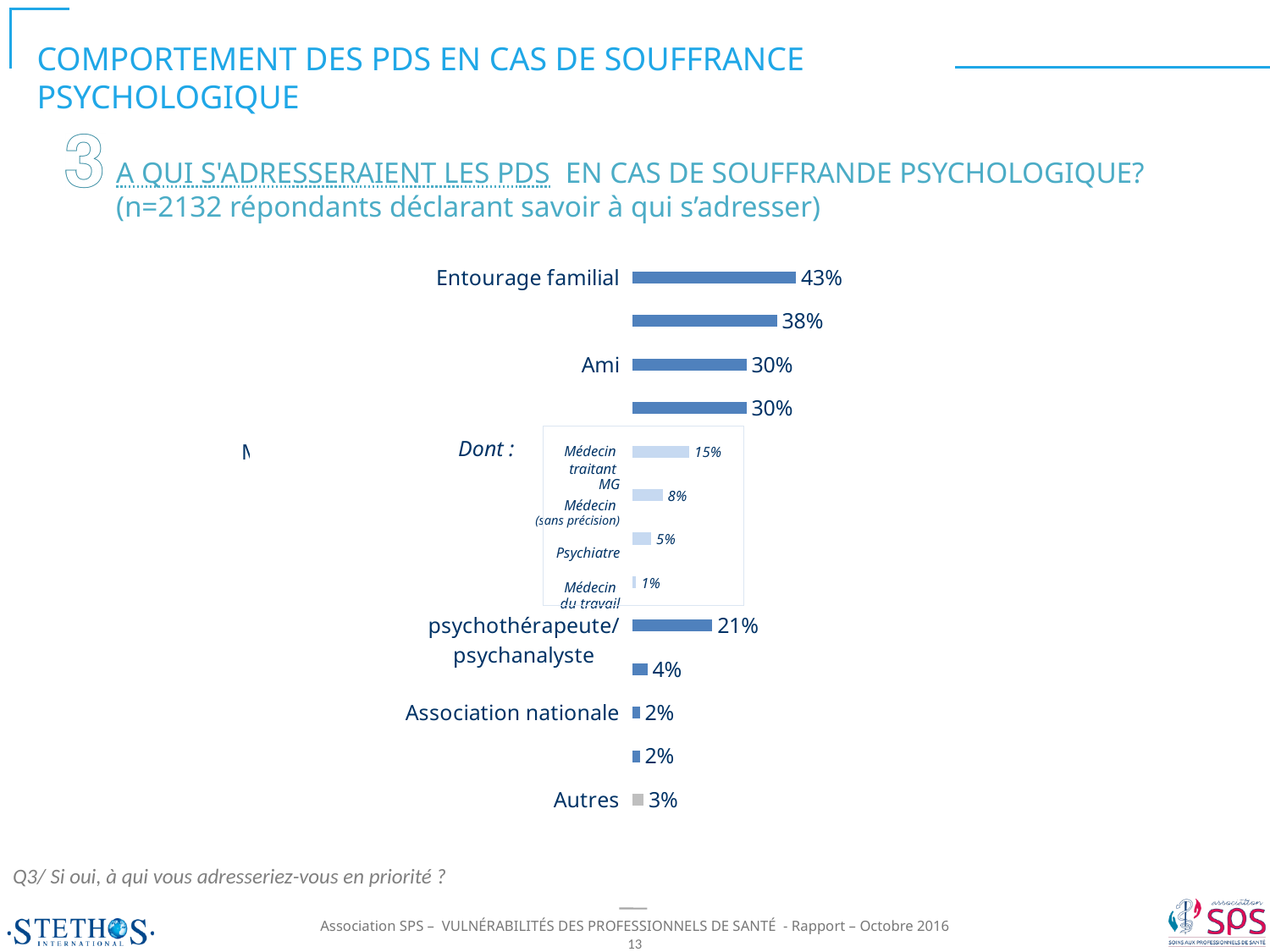
In the inset "Dont :" chart, what percentage is shown for "Psychiatre"? 5% In the main chart, which category has the highest value? Entourage familial In the inset "Dont :" chart, which category has the lowest value? Médecin du travail In the main chart, what percentage is shown for "Entourage familial"? 43% In the main chart, which is larger: the value for "Autres" or for "Association nationale"? Autres In the main chart, what percentage is shown for "Autres"? 3% In the main chart, what percentage is shown for "Association nationale"? 2% In the main chart, what percentage is shown for "Ami"? 30% In the inset "Dont :" chart, what percentage is shown for "Médecin traitant MG"? 15% In the main chart, what is the difference between the values for "Entourage familial" and "Ami"? 13 percentage points In the main chart, what percentage is shown for "psychothérapeute/ psychanalyste"? 21% What type of chart is used on this slide? Bar chart